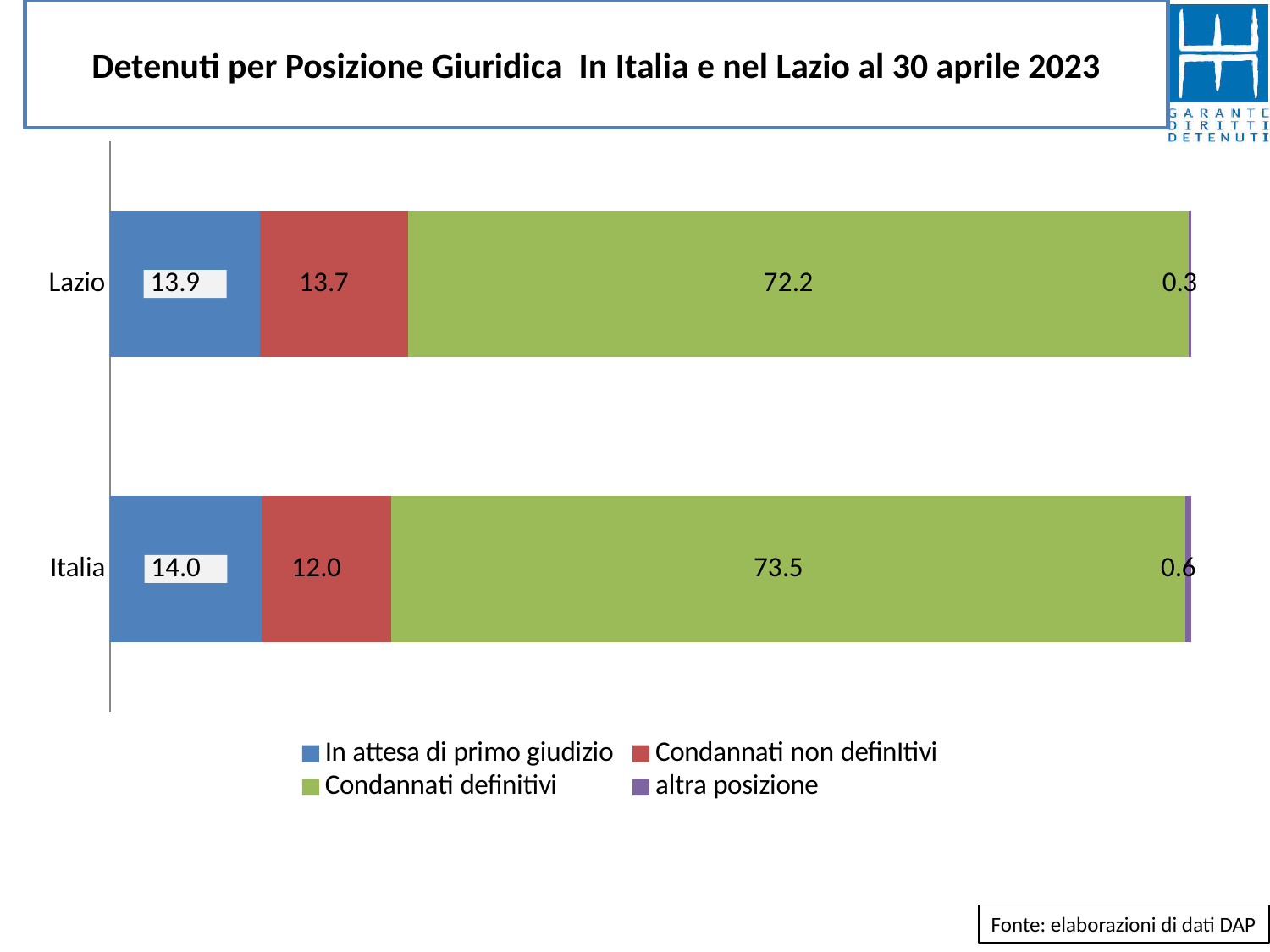
What is the value for Condannati non definitivi for Lazio? 13.7 What is the difference between the Condannati definitivi values for Italia and Lazio? 1.3 Which has the larger value for altra posizione, Italia or Lazio? Italia Which series has the smallest value for Italia? altra posizione What kind of chart is shown on the slide? Stacked bar chart What is the difference between the Condannati non definitivi values for Lazio and Italia? 1.7 What is the value for altra posizione for Italia? 0.6 How many series does the legend list? 4 Which series has the largest value for Lazio? Condannati definitivi What is the value for Condannati definitivi for Lazio? 72.2 What is the value for In attesa di primo giudizio for Italia? 14.0 How many categories are shown on the chart? 2